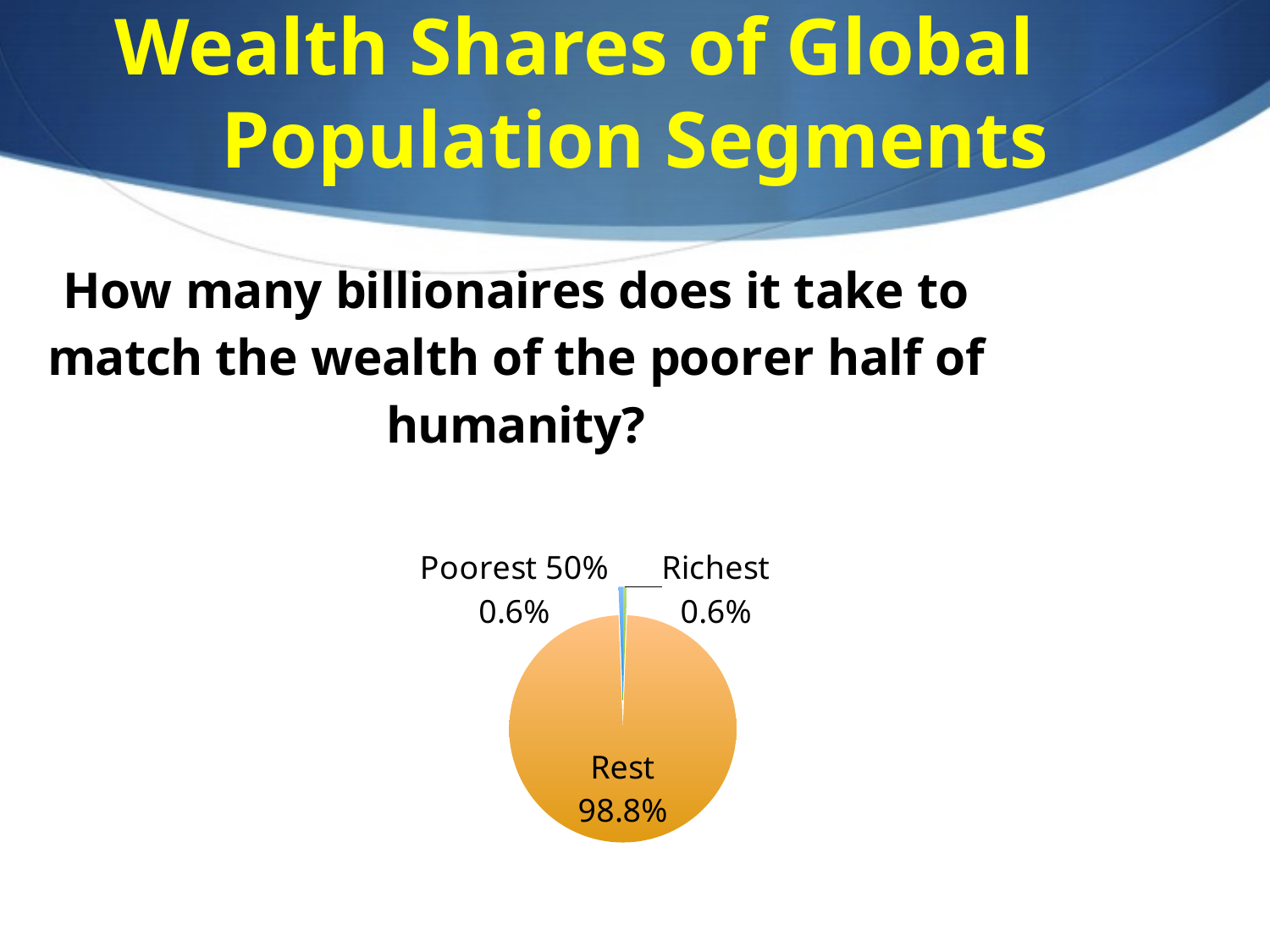
What share of wealth does the Poorest 50% segment hold? 0.6% What is the combined share of the Poorest 50% and Richest segments? 1.2% What share of wealth does the Rest segment hold? 98.8% Which segment has the largest share of the pie? Rest What kind of chart is shown on the slide? pie chart How many segments does the pie chart show? 3 What is the difference between the share for Rest and the share for Richest? 98.2% What share of wealth does the Richest segment hold? 0.6% What colour is the Rest segment of the pie? orange What is the title of the slide containing the chart? Wealth Shares of Global Population Segments Is the share for Rest greater or less than 50%? greater Is the share for Poorest 50% greater or less than 10%? less